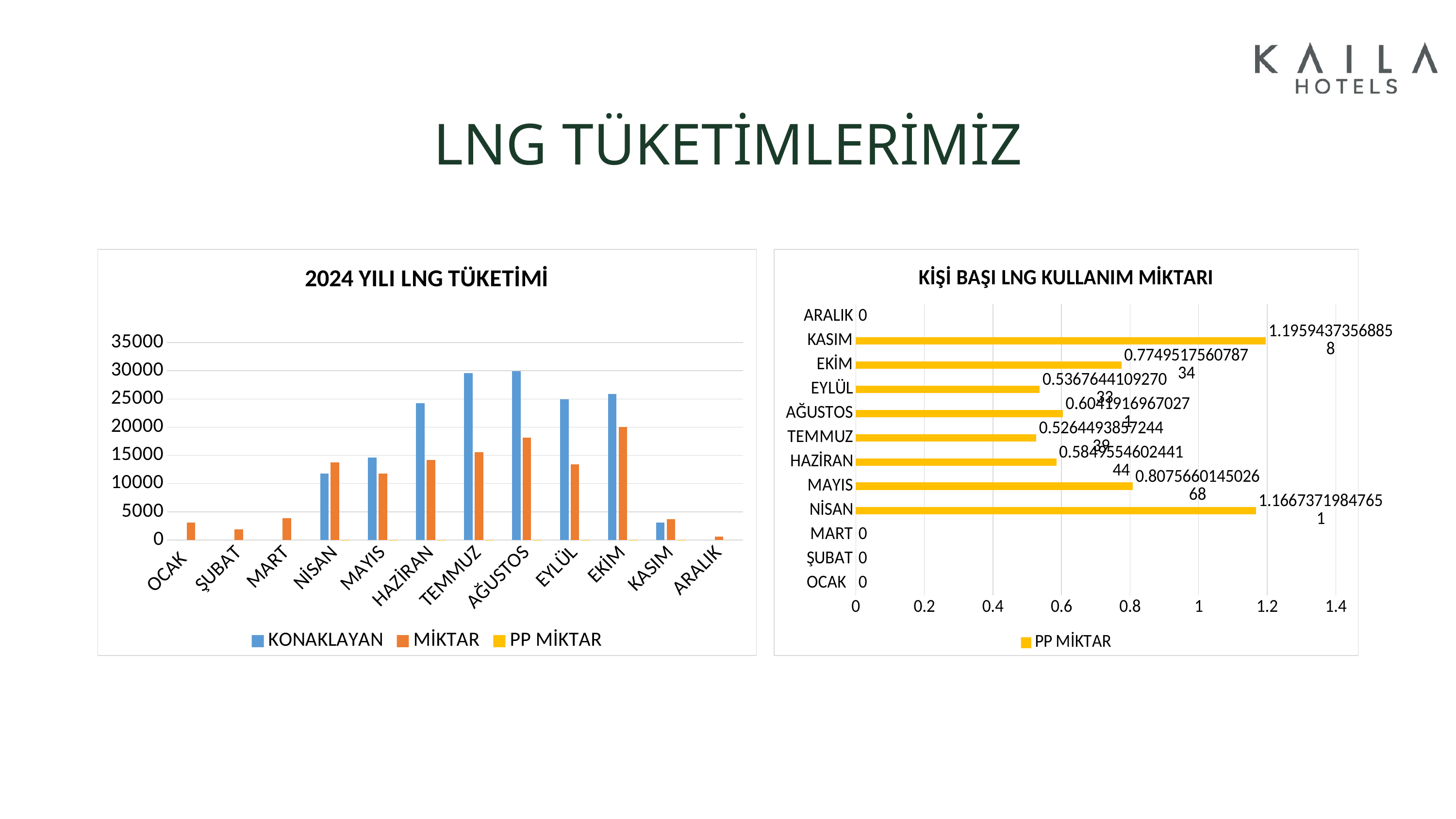
On the left chart titled '2024 YILI LNG TÜKETİMİ', which month has the highest MİKTAR value? EKİM On the right chart titled 'KİŞİ BAŞI LNG KULLANIM MİKTARI', which month has the highest PP MİKTAR value? KASIM On the left chart titled '2024 YILI LNG TÜKETİMİ', how many series does the legend list? 3 On the left chart titled '2024 YILI LNG TÜKETİMİ', is the MİKTAR value for OCAK greater or less than 5000? less On the left chart titled '2024 YILI LNG TÜKETİMİ', for NİSAN, which is larger: KONAKLAYAN or MİKTAR? MİKTAR On the right chart titled 'KİŞİ BAŞI LNG KULLANIM MİKTARI', is the value for TEMMUZ greater or less than 0.6? less On the right chart titled 'KİŞİ BAŞI LNG KULLANIM MİKTARI', what is the PP MİKTAR value for ARALIK? 0 On the left chart titled '2024 YILI LNG TÜKETİMİ', how many months are shown on the x axis? 12 What kind of chart is the right chart titled 'KİŞİ BAŞI LNG KULLANIM MİKTARI'? bar chart On the right chart titled 'KİŞİ BAŞI LNG KULLANIM MİKTARI', is the value for EKİM greater or less than 0.6? greater On the left chart titled '2024 YILI LNG TÜKETİMİ', for EKİM, which is larger: KONAKLAYAN or MİKTAR? KONAKLAYAN